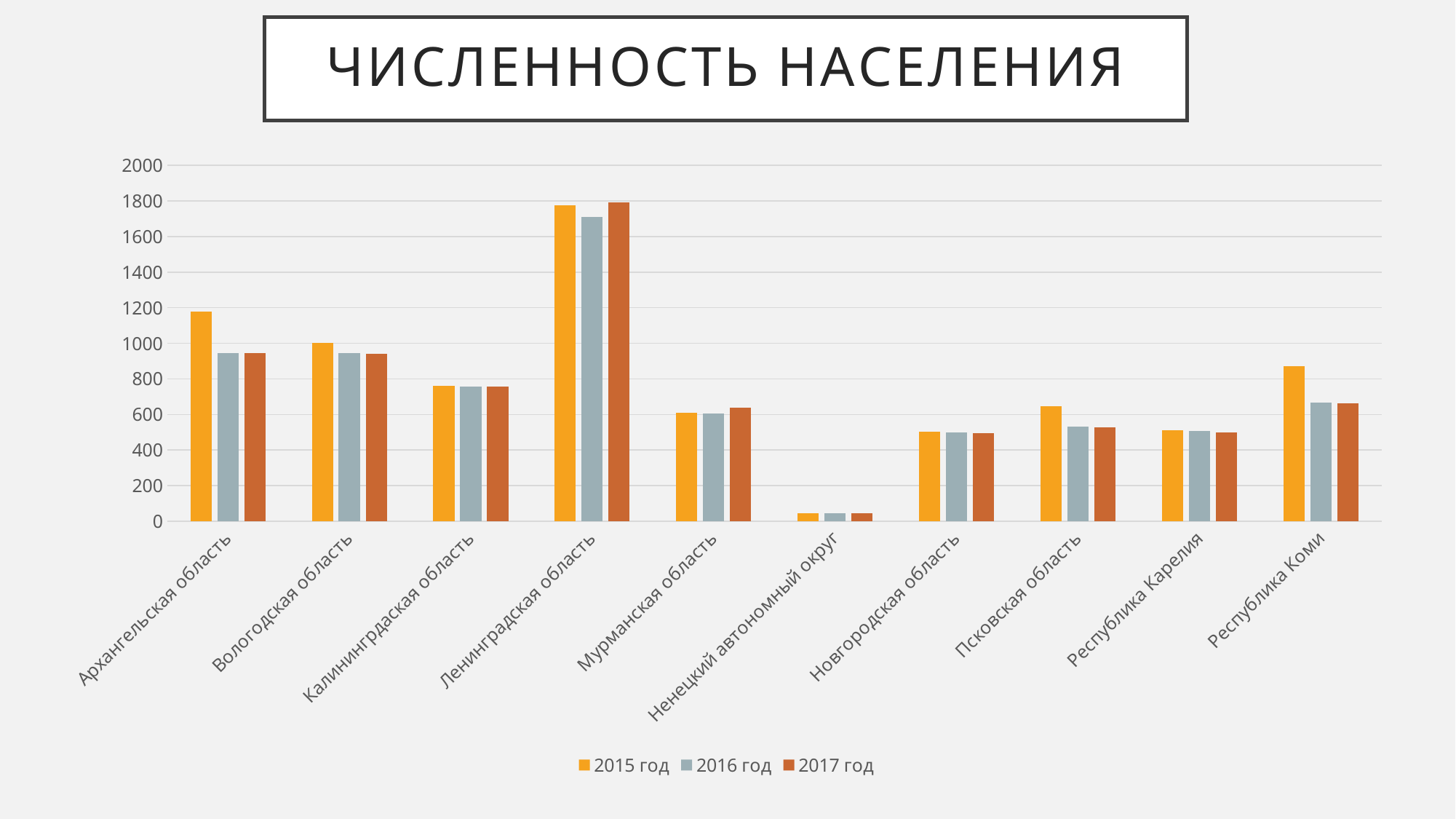
Is the value for Архангельская область in 2015 год greater or less than 1000? greater Is the value for Ленинградская область in 2017 год greater or less than 1600? greater Which region has the lowest value for 2015 год? Ненецкий автономный округ How many series does the legend list? 3 What is the title of the chart? ЧИСЛЕННОСТЬ НАСЕЛЕНИЯ Is the value for Калининградская область in 2016 год greater or less than 800? less How many regions (categories) are shown on the x axis? 10 Which is larger for 2015 год: Архангельская область or Вологодская область? Архангельская область For Ленинградская область, which is larger: the value for 2016 год or for 2017 год? 2017 год Which region has the highest value for 2017 год? Ленинградская область What kind of chart is shown on the slide? bar chart